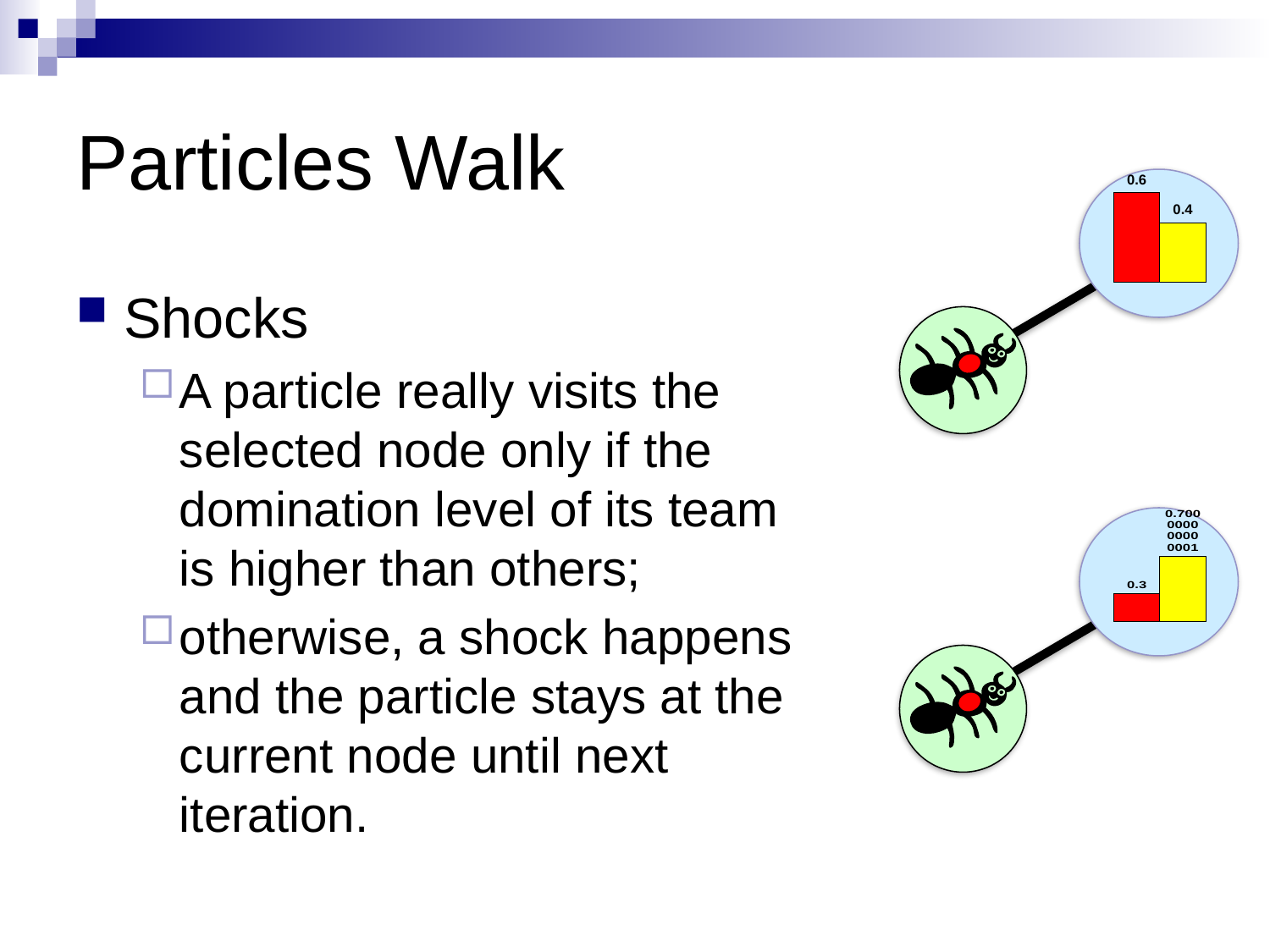
In the top-right chart, what is the value of the red bar? 0.6 In the bottom-right chart, which bar is the lowest? red In the top-right chart, what is the difference between the red bar and the yellow bar? 0.2 In the top-right chart, which bar is the highest? red What colours are the two bars in the top-right chart? red and yellow What kind of chart is shown in the top-right circle? bar chart How many bars are shown in the top-right chart? 2 In the top-right chart, which bar is taller, the red one or the yellow one? red In the bottom-right chart, which bar is taller, the red one or the yellow one? yellow In the bottom-right chart, what is the value of the red bar? 0.3 How many bars are shown in the bottom-right chart? 2 In the top-right chart, what is the value of the yellow bar? 0.4